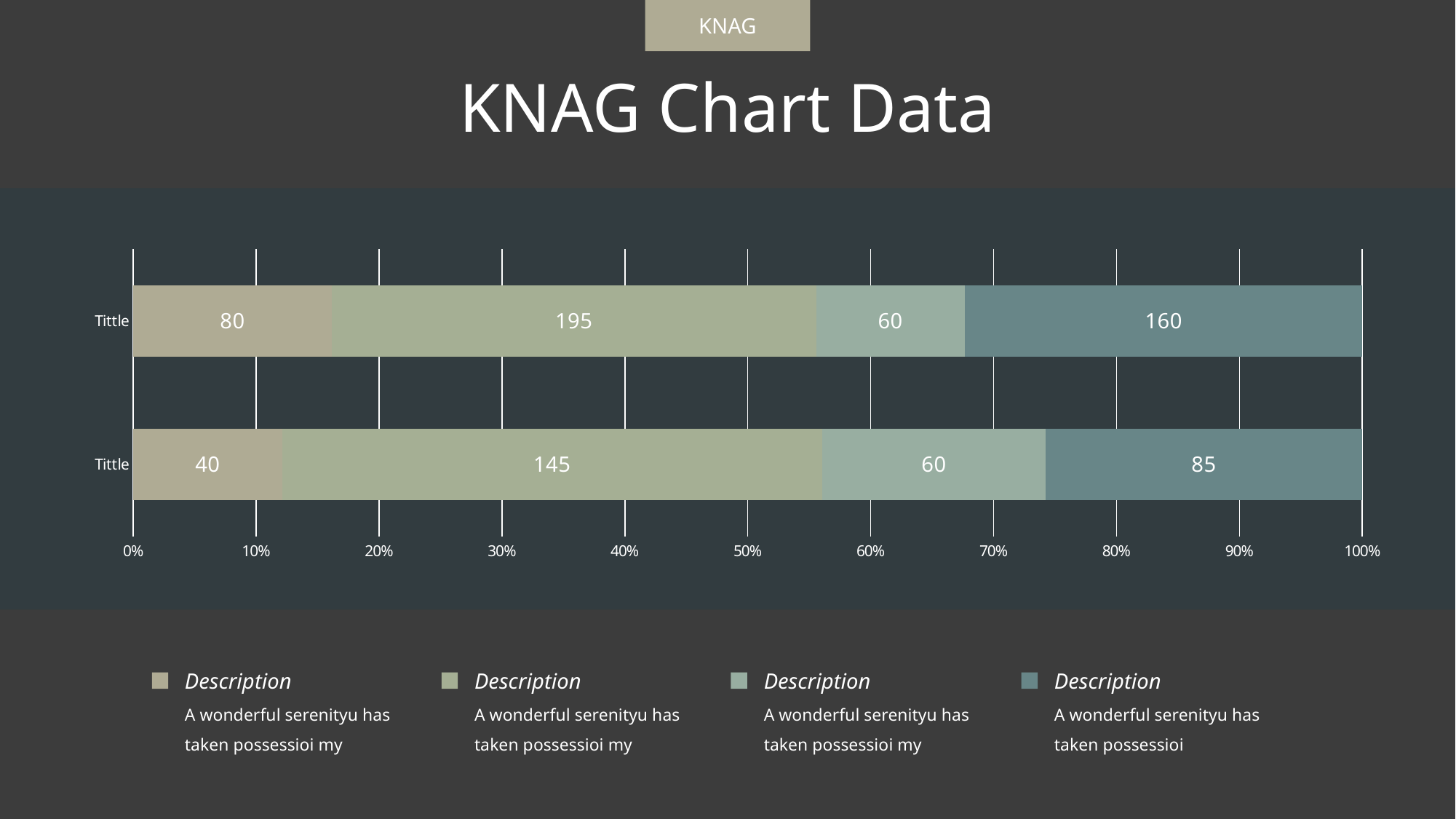
What kind of chart is shown on the slide? Stacked bar chart How many segments (series) make up each bar? 4 What is the total of all segments in the bottom bar? 330 Which segment of the top bar has the largest value? 195 Which segment of the bottom bar has the smallest value? 40 How many bars (categories) does the chart show? 2 What is the value of the first (leftmost) segment of the top bar? 80 What is the value of the second segment of the bottom bar? 145 What is the total of all segments in the top bar? 495 What is the difference between the second segment of the top bar (195) and the second segment of the bottom bar (145)? 50 What is the value of the last (rightmost) segment of the top bar? 160 Which is larger: the last segment of the top bar or the last segment of the bottom bar? The top bar's last segment (160)